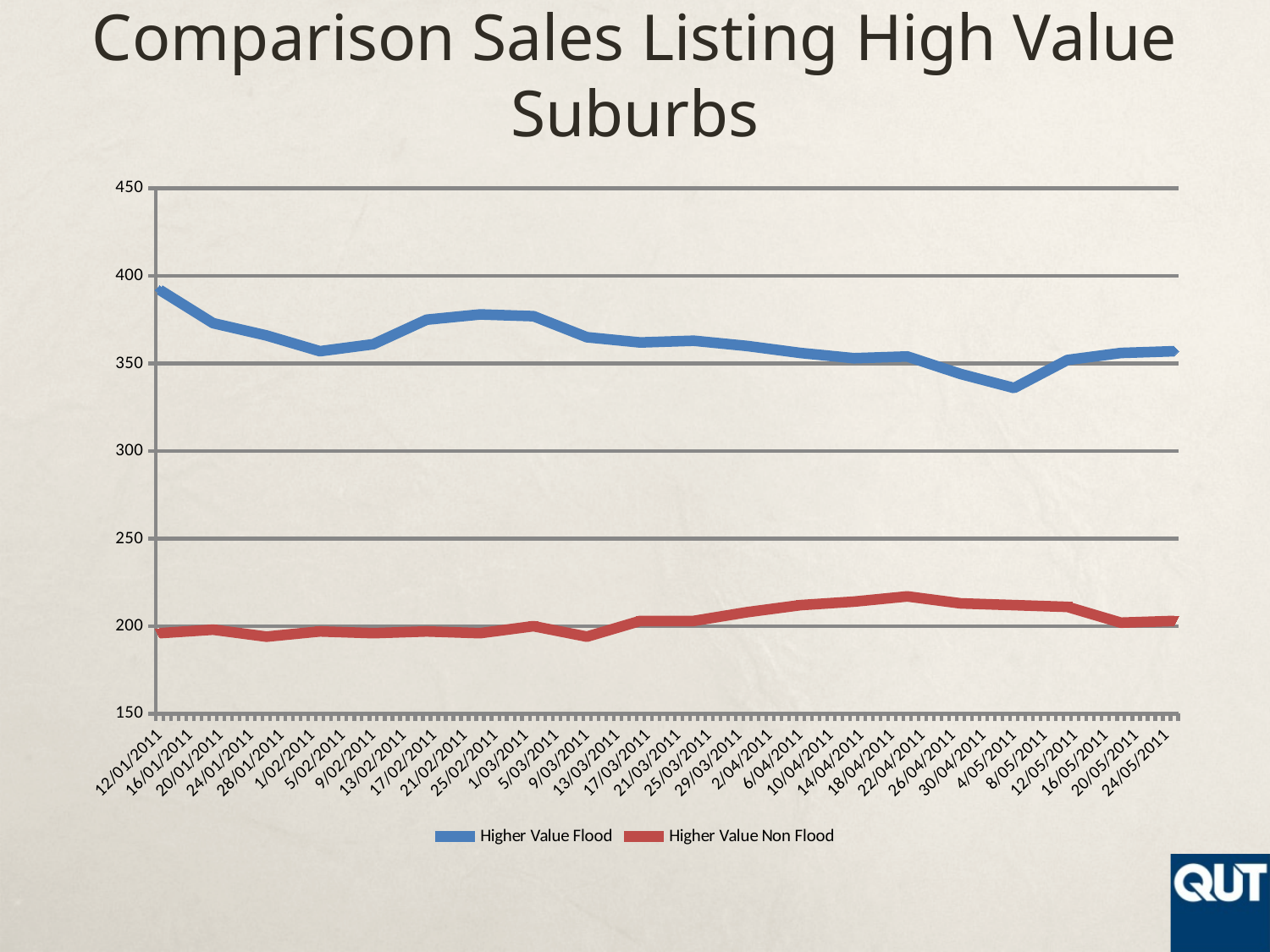
Which series has the higher value on 21/03/2011, Higher Value Flood or Higher Value Non Flood? Higher Value Flood Which colour represents the Higher Value Non Flood series? red Is the value for Higher Value Non Flood on 12/01/2011 greater or less than 250? less Does the Higher Value Flood series rise or fall between 12/01/2011 and 1/02/2011? fall Is the value for Higher Value Non Flood on 18/04/2011 greater or less than 200? greater On which date does the Higher Value Flood series reach its lowest value? 4/05/2011 Is the value for Higher Value Flood on 4/05/2011 greater or less than 350? less How many series does the legend list? 2 What is the title of the chart? Comparison Sales Listing High Value Suburbs What kind of chart is shown on the slide? line chart On which date does the Higher Value Flood series reach its highest value? 12/01/2011